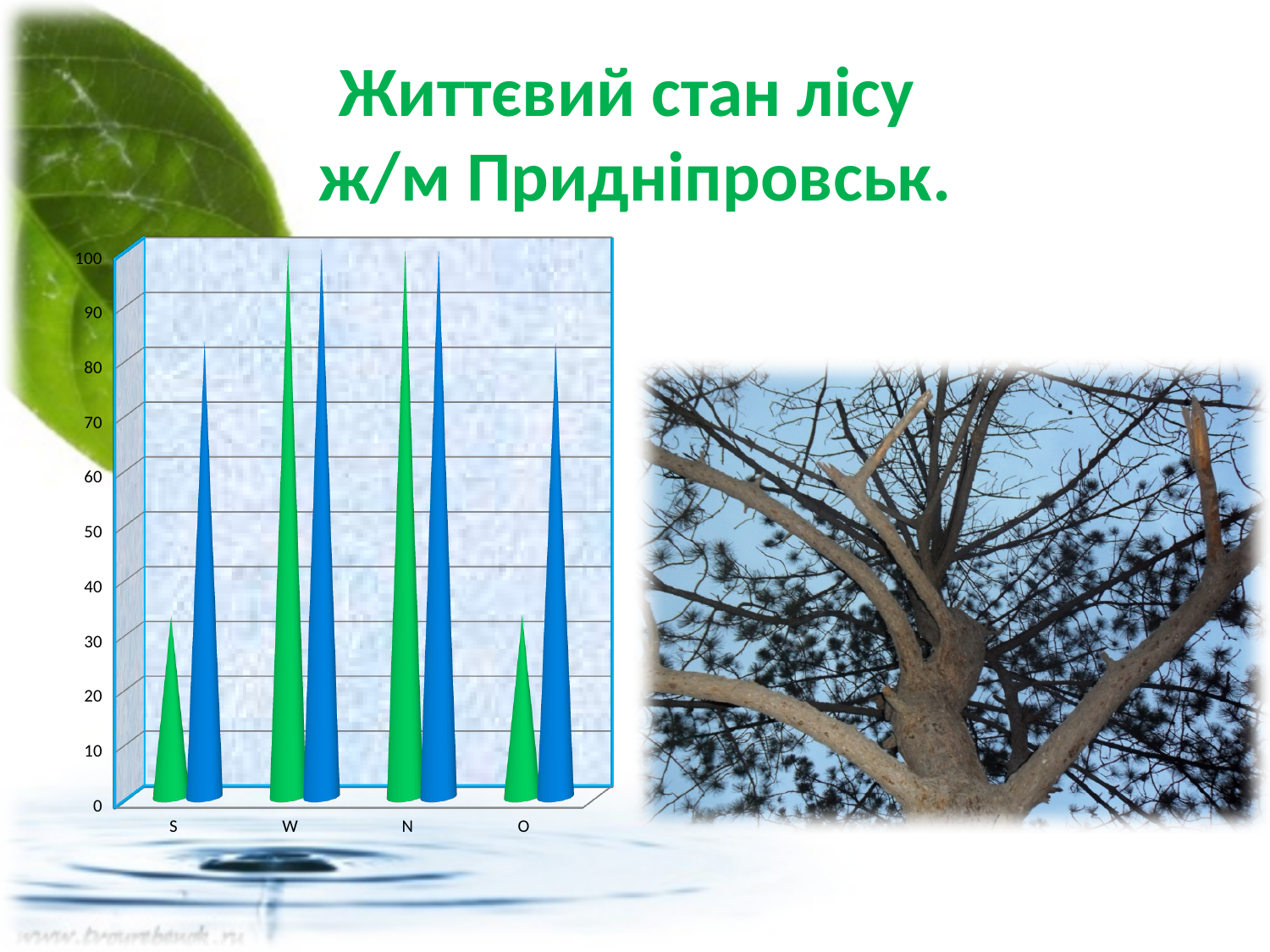
What is the title of the slide containing the chart? Життєвий стан лісу ж/м Придніпровськ. Is the value of the blue bar for O greater or less than 70? greater What kind of chart is shown on the slide? bar chart Is the value of the green bar for O greater or less than 40? less Which is larger, the green bar for W or the green bar for S? the green bar for W For category O, which bar is taller, the green one or the blue one? the blue one Is the value of the blue bar for S greater or less than 70? greater What is the highest value shown on the chart's vertical axis? 100 How many categories are shown on the x axis of the chart? 4 For category S, which bar is taller, the green one or the blue one? the blue one